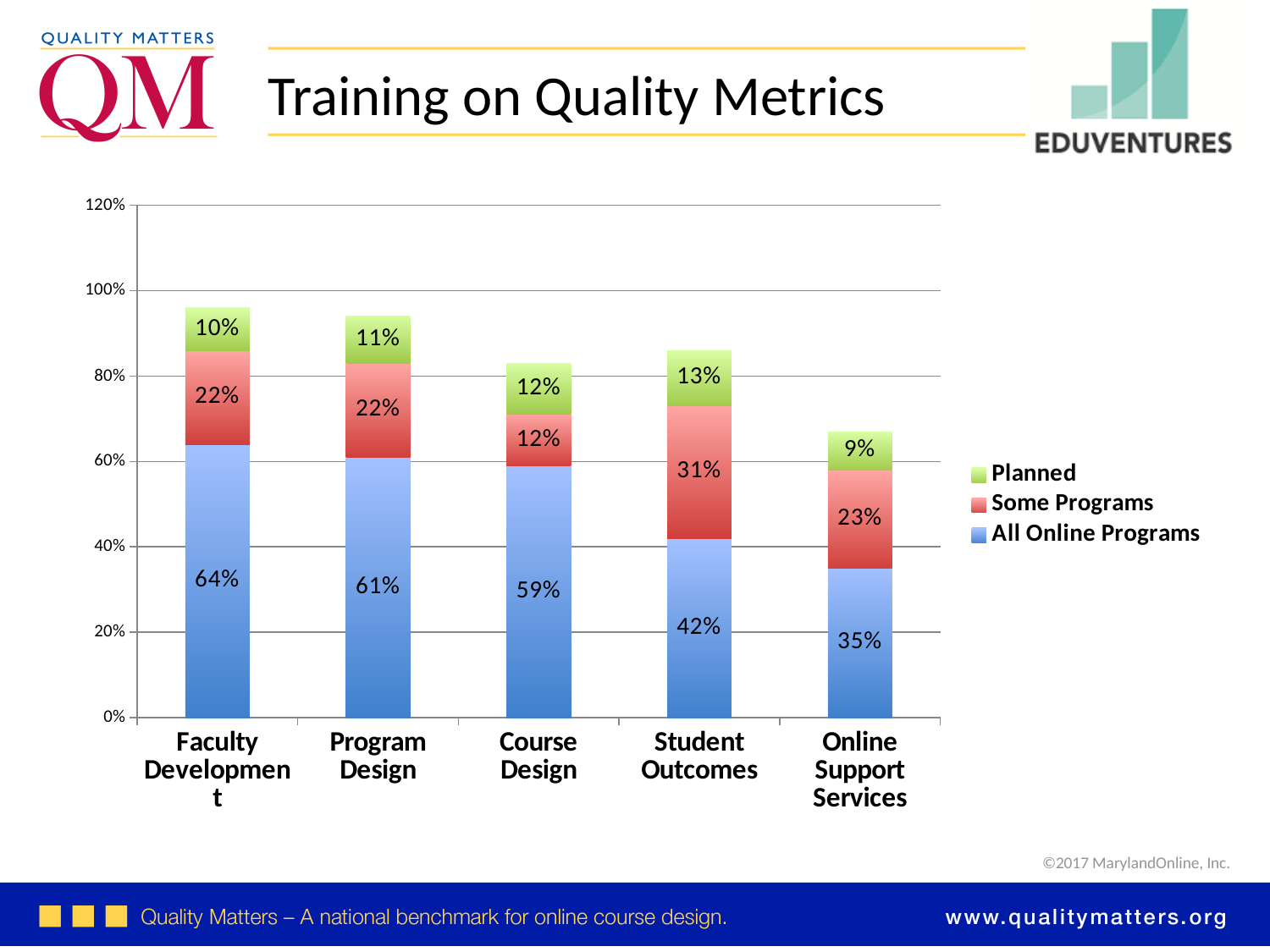
Which category has the highest All Online Programs value? Faculty Development Which is larger, the All Online Programs value for Program Design or for Online Support Services? Program Design What is the Some Programs value for Online Support Services? 23% How many series does the legend list? 3 What kind of chart is shown on the slide? Stacked bar chart Which category has the lowest Planned value? Online Support Services How many categories are shown on the x axis? 5 What is the total of the stacked bar for Faculty Development? 96% What is the total of the stacked bar for Online Support Services? 67% What is the Planned value for Course Design? 12% What is the All Online Programs value for Student Outcomes? 42% What is the difference between the Some Programs values for Student Outcomes and Course Design? 19%